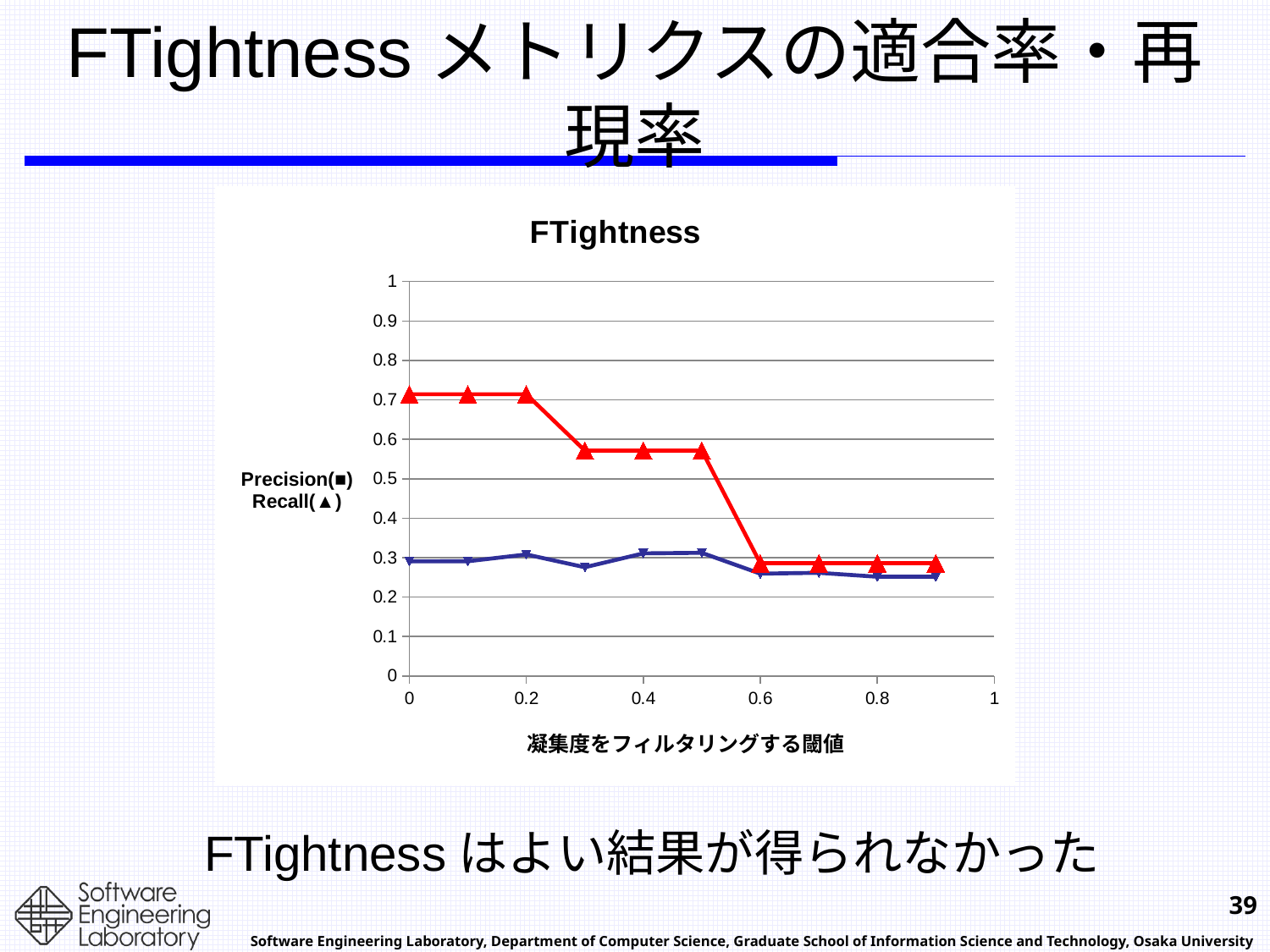
Does the Recall (▲) series rise or fall as the threshold on the x axis increases? fall Is the Recall (▲) value at threshold 0.8 greater or less than 0.4? less What kind of chart is shown on the slide? line chart At threshold 0.2, which series has the larger value, Precision (■) or Recall (▲)? Recall (▲) Is the Recall (▲) value at threshold 0.4 greater or less than 0.5? greater What is the label of the x axis? 凝集度をフィルタリングする閾値 Is the Recall (▲) value at threshold 0 greater or less than 0.6? greater How many series does the chart plot? 2 What is the title of the chart? FTightness How many data points does the Recall (▲) series have? 10